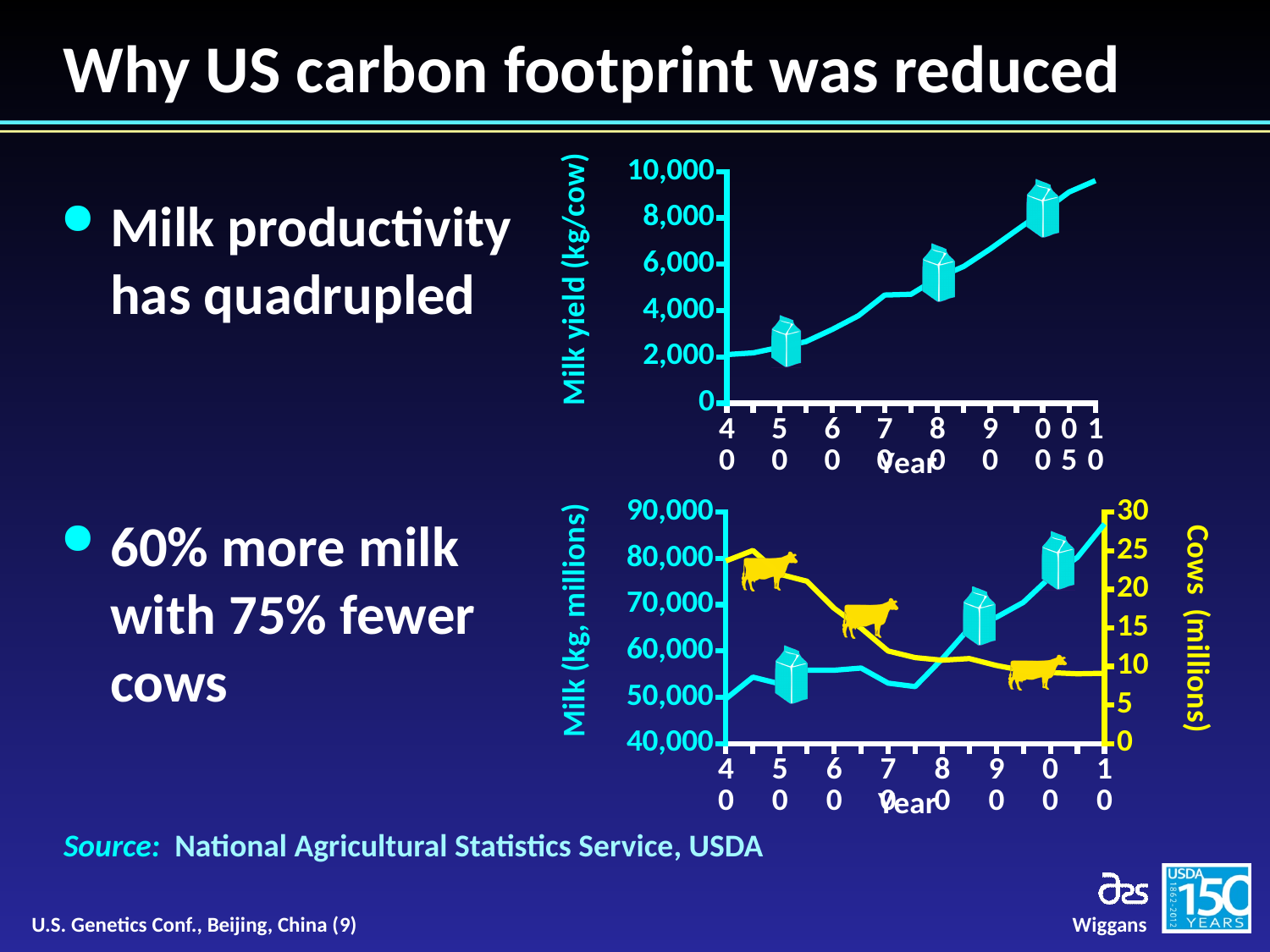
In the bottom chart, does the Cows (millions) line rise or fall from 1940 to 2010? Fall In the top chart (Milk yield), is the value for 2010 greater or less than 8,000? greater What is the label on the vertical axis of the top chart? Milk yield (kg/cow) What type of chart is the top chart on the slide? Line chart In the top chart (Milk yield), do the values rise or fall from 1940 to 2010? Rise In the bottom chart, is the Cows (millions) value for 1940 greater or less than 20? greater In the bottom chart, is the Milk (kg, millions) value for 2010 greater or less than 80,000? greater In the bottom chart, does the Milk (kg, millions) line rise or fall from 1940 to 2010? Rise